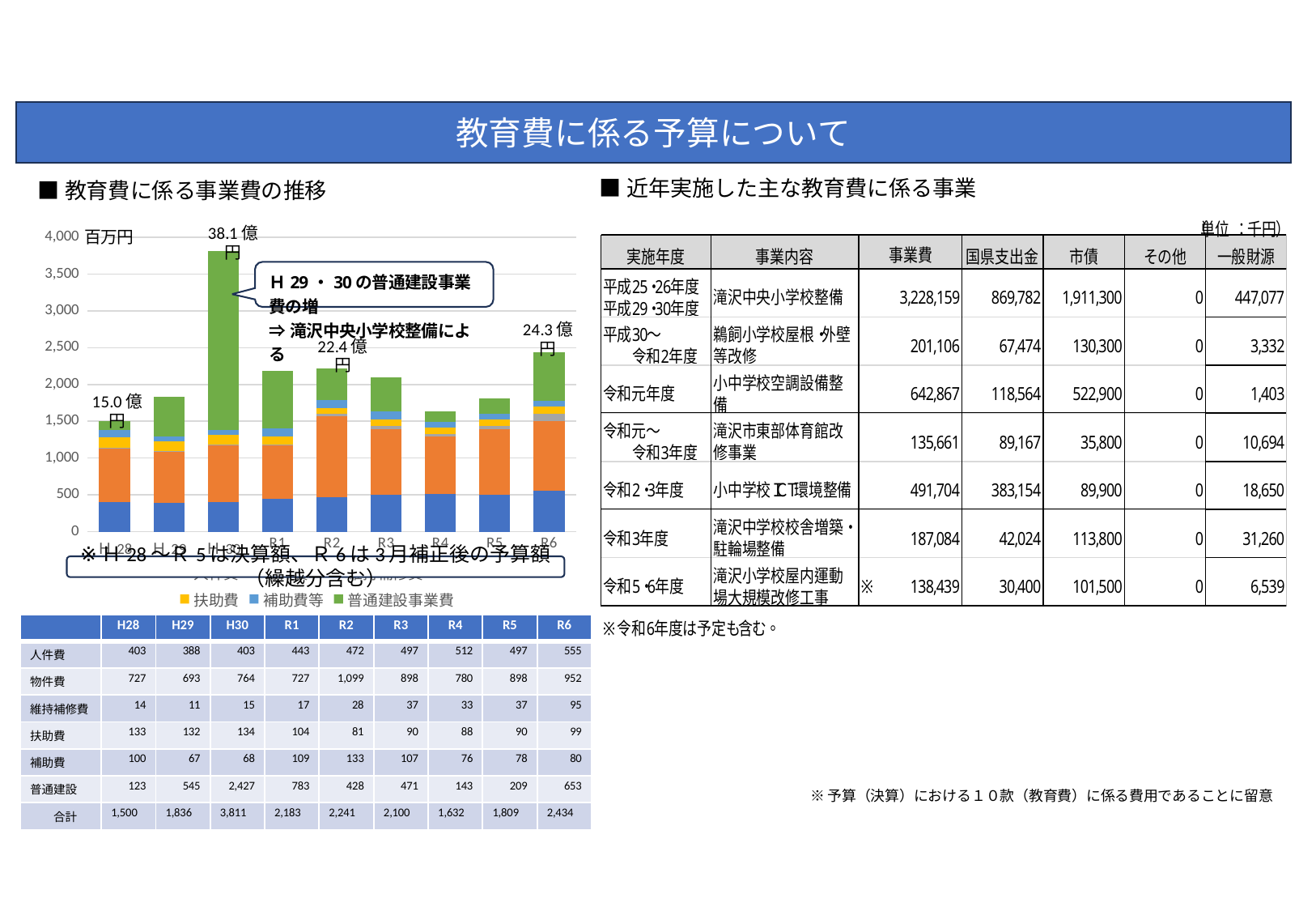
What kind of chart is used to show 教育費に係る事業費の推移? Stacked bar chart What unit is shown at the top of the y axis of the 教育費に係る事業費の推移 chart? 百万円 What is the difference between the labelled totals for H30 and H28 in the 教育費に係る事業費の推移 chart? 23.1億円 What total value is labelled on the H30 bar in the 教育費に係る事業費の推移 chart? 38.1億円 Which fiscal year has the highest total in the 教育費に係る事業費の推移 chart? H30 Which bar is taller in the 教育費に係る事業費の推移 chart, R2 or R6? R6 Is the total for H29 in the 教育費に係る事業費の推移 chart greater or less than 1,500? greater What total value is labelled on the R6 bar in the 教育費に係る事業費の推移 chart? 24.3億円 How many fiscal years are plotted on the x axis of the 教育費に係る事業費の推移 chart? 9 Is the total for R5 in the 教育費に係る事業費の推移 chart greater or less than 2,000? less Do the bar totals rise or fall from R2 to R4 in the 教育費に係る事業費の推移 chart? fall Which fiscal year has the lowest total in the 教育費に係る事業費の推移 chart? H28